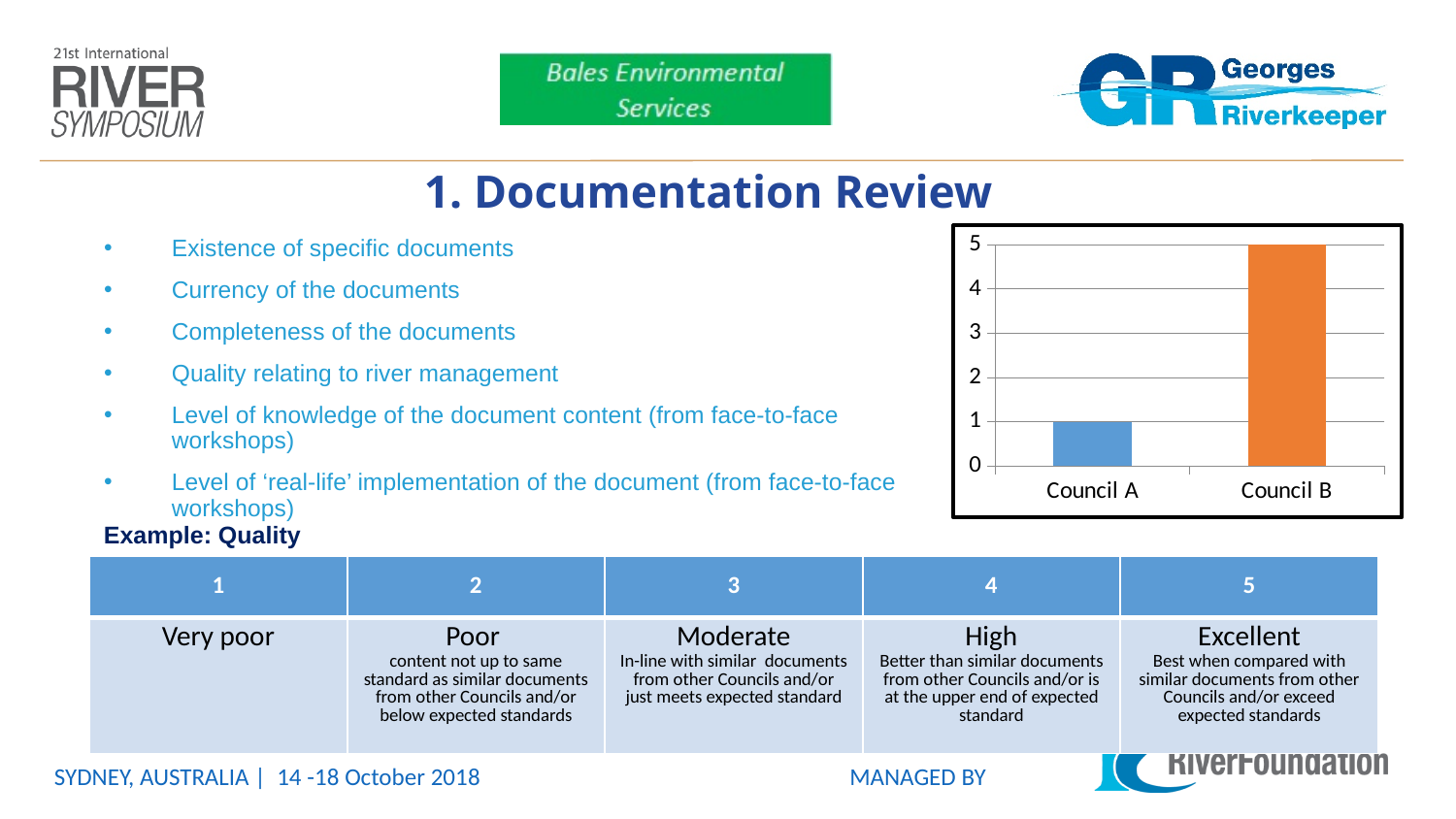
Which is larger, the value for Council A or the value for Council B? Council B How many categories are shown on the x axis of the chart? 2 Which council has the lowest value in the chart? Council A What is the value for Council A in the chart? 1 What is the difference between the values for Council B and Council A? 4 What is the value for Council B in the chart? 5 What colour is the bar for Council B? orange Is the value for Council B greater or less than 3? greater What type of chart is shown on the slide? bar chart What is the maximum value shown on the y axis of the chart? 5 Is the value for Council A greater or less than 2? less Which council has the highest value in the chart? Council B